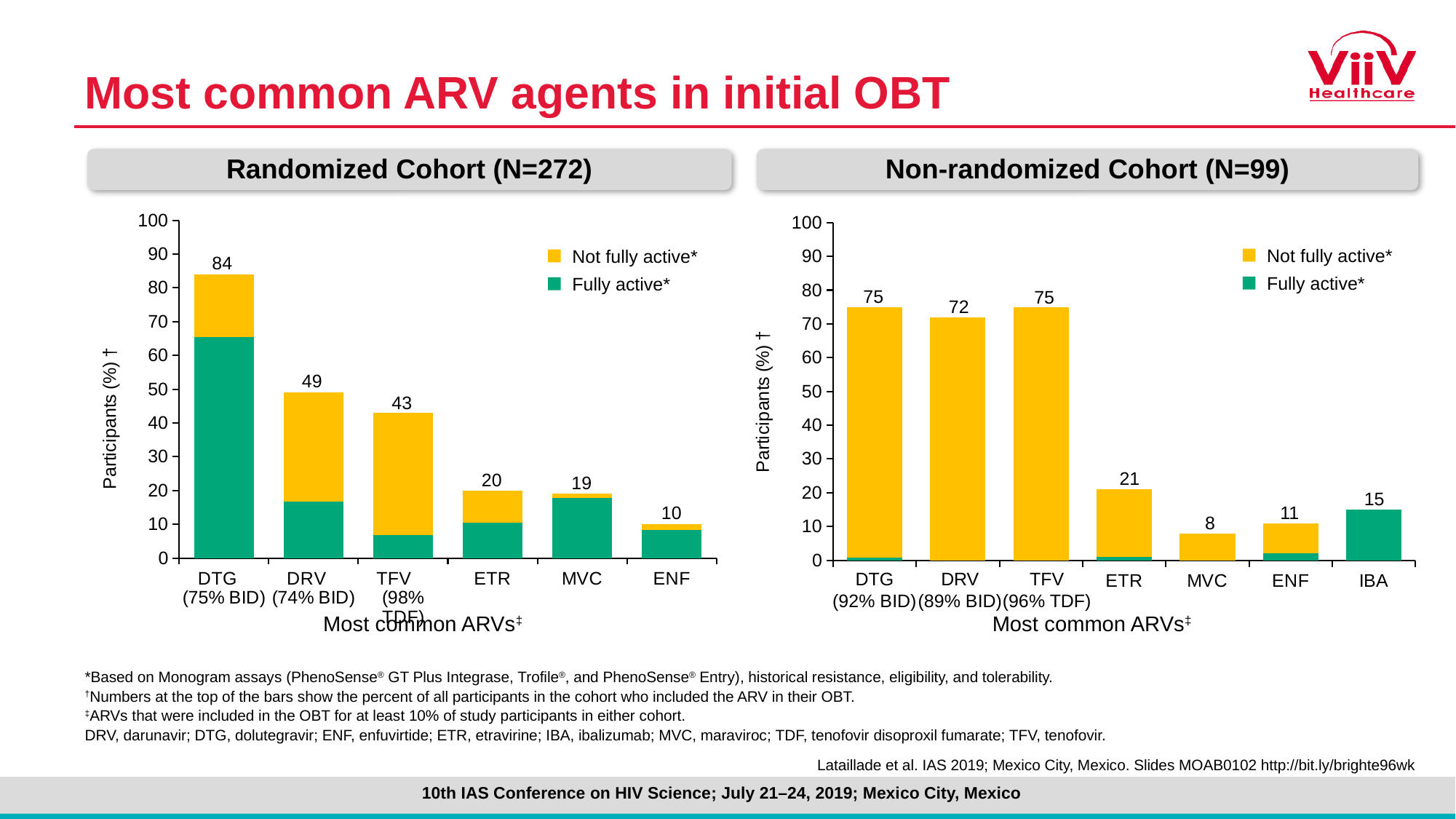
In the Randomized Cohort (N=272) chart, what is the total value shown above the DTG bar? 84 What type of chart is used for the Randomized Cohort (N=272)? Stacked bar chart In the Randomized Cohort (N=272) chart, is the Fully active* portion of the DTG bar greater or less than 60? greater In the Non-randomized Cohort (N=99) chart, what is the value shown above the ETR bar? 21 In the Non-randomized Cohort (N=99) chart, which ARV has the lowest total value? MVC In the Randomized Cohort (N=272) chart, what is the difference between the total values for DRV and TFV? 6 In the Randomized Cohort (N=272) chart, which ARV has the highest total value? DTG How many series does the legend of the Randomized Cohort (N=272) chart list? 2 How many ARV categories are shown on the x axis of the Non-randomized Cohort (N=99) chart? 7 In the Non-randomized Cohort (N=99) chart, which has a larger total value, DRV or TFV? TFV In the Non-randomized Cohort (N=99) chart, what is the difference between the total values for IBA and ENF? 4 In the Randomized Cohort (N=272) chart, which ARV has the lowest total value? ENF